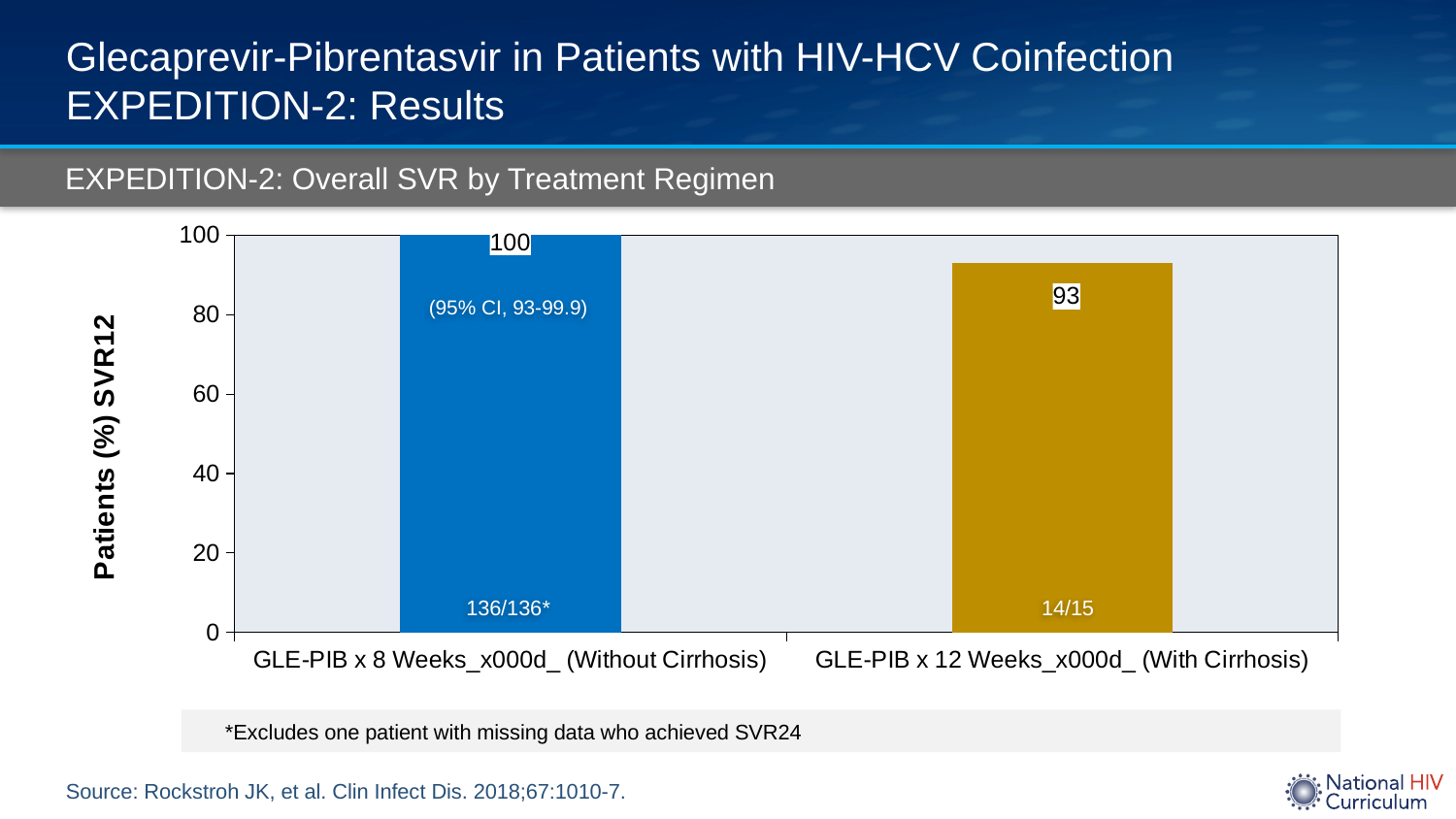
What is the SVR12 value for GLE-PIB x 8 Weeks (Without Cirrhosis)? 100 What is the 95% confidence interval shown for the GLE-PIB x 8 Weeks (Without Cirrhosis) bar? 93-99.9 What is the difference in SVR12 between the 8-week and 12-week regimens? 7 Is the SVR12 value for GLE-PIB x 12 Weeks (With Cirrhosis) greater or less than 80? greater How many treatment regimens are shown in the chart? 2 What fraction of patients is shown for the GLE-PIB x 8 Weeks (Without Cirrhosis) bar? 136/136* Which treatment regimen has the lower SVR12 rate? GLE-PIB x 12 Weeks (With Cirrhosis) Which treatment regimen has the higher SVR12 rate? GLE-PIB x 8 Weeks (Without Cirrhosis) What is the SVR12 value for GLE-PIB x 12 Weeks (With Cirrhosis)? 93 What fraction of patients is shown for the GLE-PIB x 12 Weeks (With Cirrhosis) bar? 14/15 What kind of chart is shown on the slide? bar chart What is the title of the chart? EXPEDITION-2: Overall SVR by Treatment Regimen